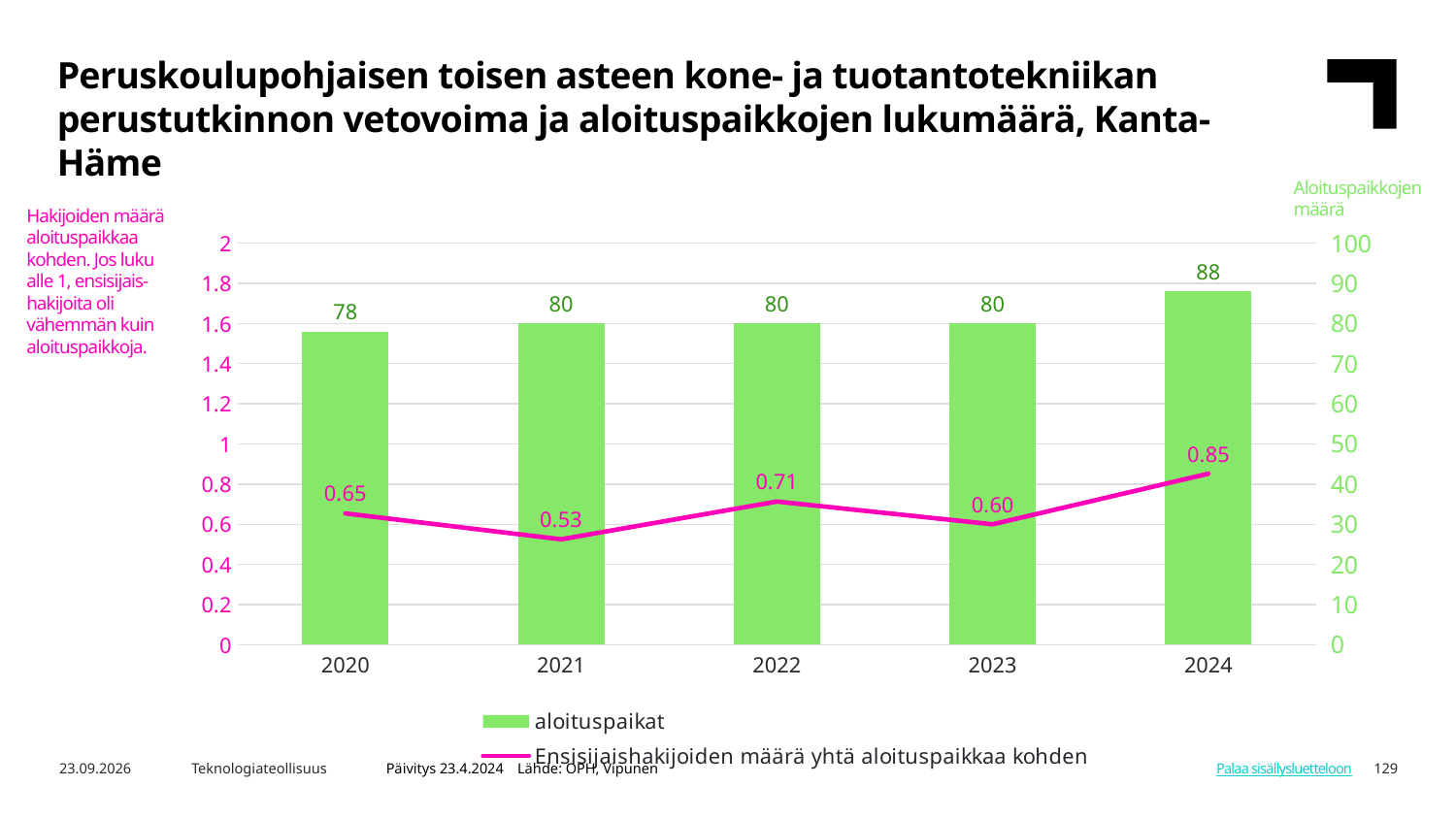
What colour are the aloituspaikat bars? Green What is the value of aloituspaikat in 2020? 78 In which year is Ensisijaishakijoiden määrä yhtä aloituspaikkaa kohden highest? 2024 What is the value of Ensisijaishakijoiden määrä yhtä aloituspaikkaa kohden in 2021? 0.53 What is the difference in Ensisijaishakijoiden määrä yhtä aloituspaikkaa kohden between 2022 and 2023? 0.11 How many series does the legend list? 2 What is the difference in aloituspaikat between 2024 and 2020? 10 In which year is Ensisijaishakijoiden määrä yhtä aloituspaikkaa kohden lowest? 2021 In which year is aloituspaikat lowest? 2020 Which year has a higher value of Ensisijaishakijoiden määrä yhtä aloituspaikkaa kohden, 2020 or 2023? 2020 How many years are shown on the x axis? 5 What is the value of aloituspaikat in 2024? 88